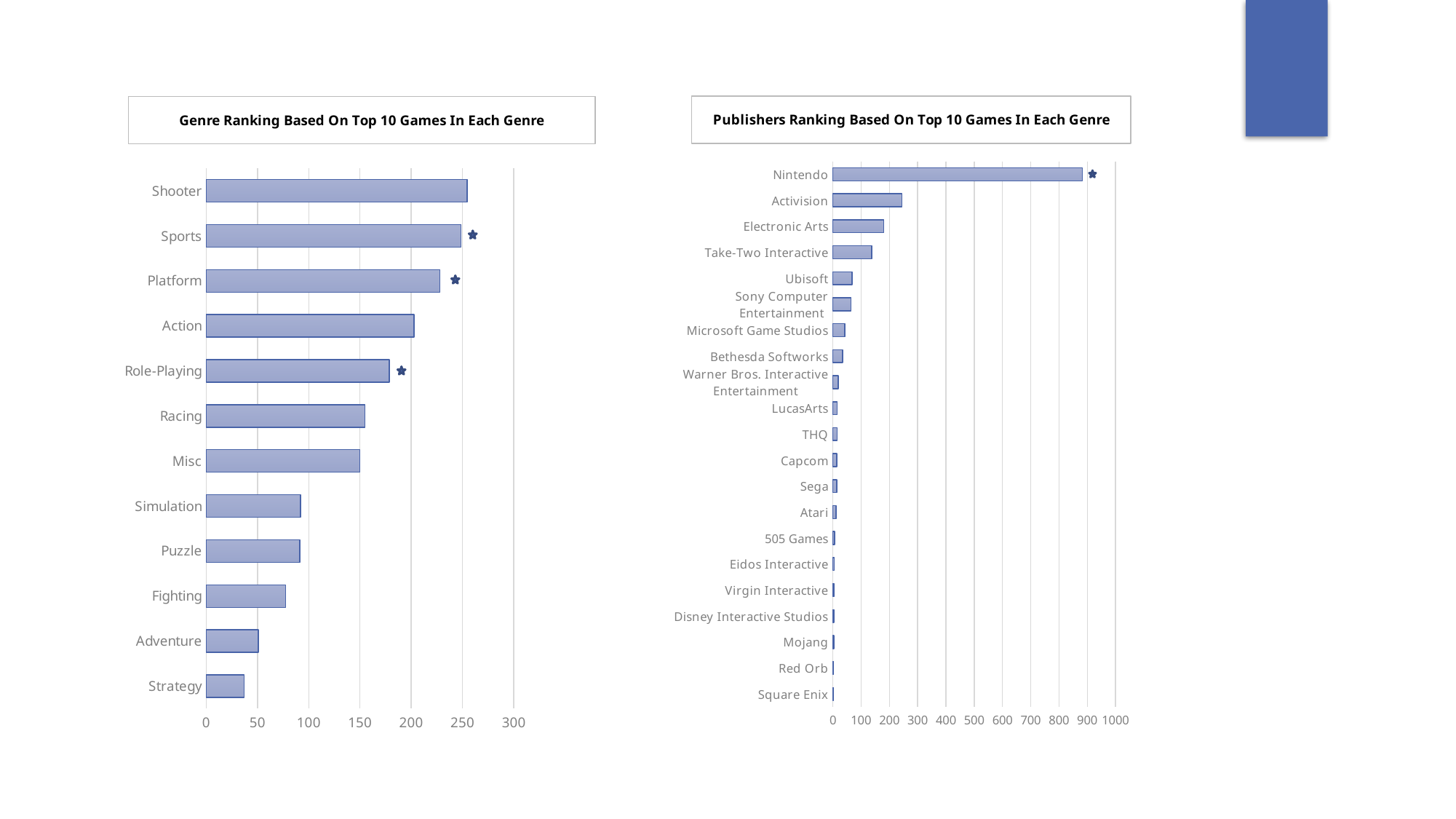
In the 'Genre Ranking Based On Top 10 Games In Each Genre' chart, is the value for Simulation greater or less than 100? less In the 'Genre Ranking Based On Top 10 Games In Each Genre' chart, which genre has the highest value? Shooter In the 'Publishers Ranking Based On Top 10 Games In Each Genre' chart, is the value for Nintendo greater or less than 800? greater In the 'Genre Ranking Based On Top 10 Games In Each Genre' chart, which is larger, Platform or Racing? Platform In the 'Publishers Ranking Based On Top 10 Games In Each Genre' chart, how many publishers are plotted? 21 In the 'Genre Ranking Based On Top 10 Games In Each Genre' chart, how many genres are plotted? 12 What kind of chart is the 'Genre Ranking Based On Top 10 Games In Each Genre' chart? Bar chart In the 'Genre Ranking Based On Top 10 Games In Each Genre' chart, is the value for Role-Playing greater or less than 200? less In the 'Genre Ranking Based On Top 10 Games In Each Genre' chart, which genre has the lowest value? Strategy In the 'Publishers Ranking Based On Top 10 Games In Each Genre' chart, which publisher has the highest value? Nintendo In the 'Genre Ranking Based On Top 10 Games In Each Genre' chart, how many genres are marked with a star? 3 In the 'Publishers Ranking Based On Top 10 Games In Each Genre' chart, which is larger, Activision or Ubisoft? Activision